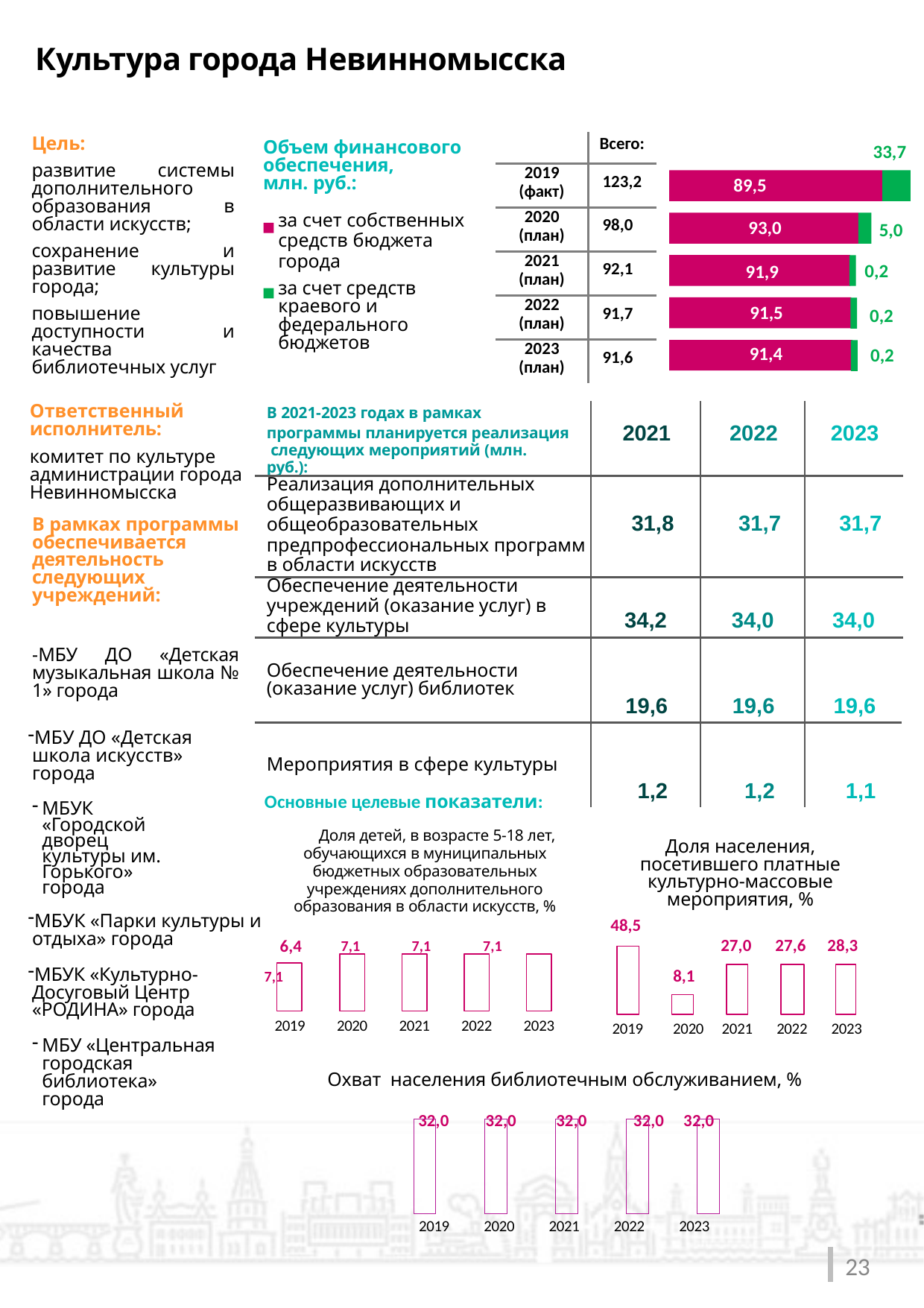
In the chart 'Объем финансового обеспечения, млн. руб.', what is the total (Всего) for 2021 (план)? 92,1 In the chart 'Объем финансового обеспечения, млн. руб.', how many series does the legend list? 2 In the chart 'Доля населения, посетившего платные культурно-массовые мероприятия, %', which year has the highest value? 2019 In the chart 'Объем финансового обеспечения, млн. руб.', what is the difference between the own city budget funds in 2020 (план) and 2019 (факт)? 3,5 In the chart 'Охват населения библиотечным обслуживанием, %', what is the value for 2022? 32,0 What kind of chart is 'Охват населения библиотечным обслуживанием, %'? bar chart In the chart 'Объем финансового обеспечения, млн. руб.', what is the value for regional and federal budget funds in 2020 (план)? 5,0 In the chart 'Доля населения, посетившего платные культурно-массовые мероприятия, %', what is the difference between 2023 and 2021? 1,3 In the chart 'Доля населения, посетившего платные культурно-массовые мероприятия, %', what is the value for 2020? 8,1 In the chart 'Доля населения, посетившего платные культурно-массовые мероприятия, %', which year has the lowest value? 2020 In the chart 'Объем финансового обеспечения, млн. руб.', which year has the largest regional and federal budget contribution? 2019 (факт) In the chart 'Объем финансового обеспечения, млн. руб.', what is the value for own city budget funds (за счет собственных средств бюджета города) in 2019 (факт)? 89,5